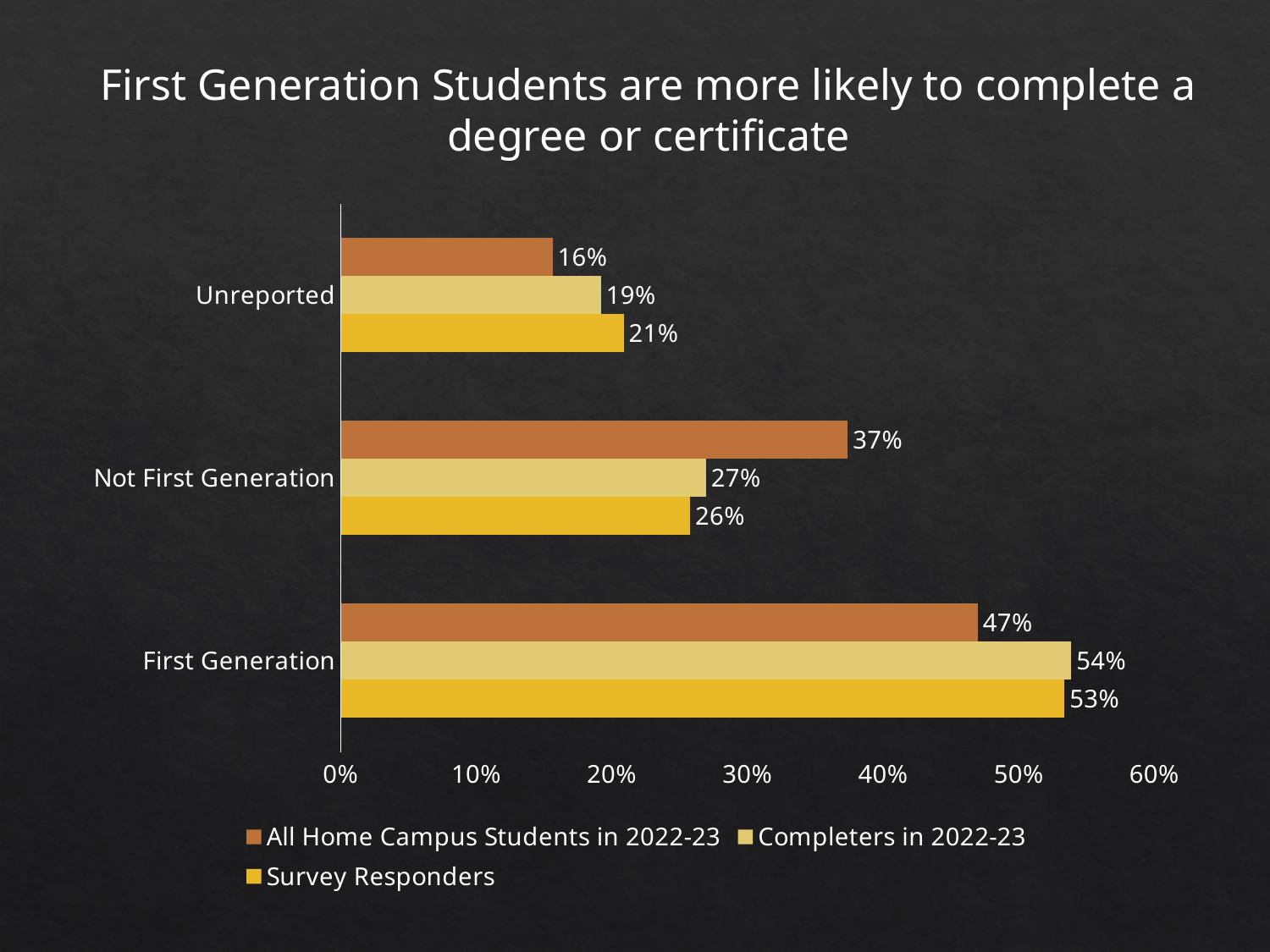
How many categories are shown on the chart? 3 What is the title of the slide? First Generation Students are more likely to complete a degree or certificate What is the difference between the First Generation values for Completers in 2022-23 and All Home Campus Students in 2022-23? 7% Which category has the highest value for All Home Campus Students in 2022-23? First Generation Which category has the lowest value for Completers in 2022-23? Unreported How many series does the legend list? 3 What is the value for All Home Campus Students in 2022-23 in the Unreported category? 16% What kind of chart is shown on the slide? Bar chart What percentage of Completers in 2022-23 were First Generation? 54% What is the value for Survey Responders in the Not First Generation category? 26% In the Not First Generation category, which is larger: All Home Campus Students in 2022-23 or Completers in 2022-23? All Home Campus Students in 2022-23 Is the value for Survey Responders in the First Generation category greater or less than 50%? greater